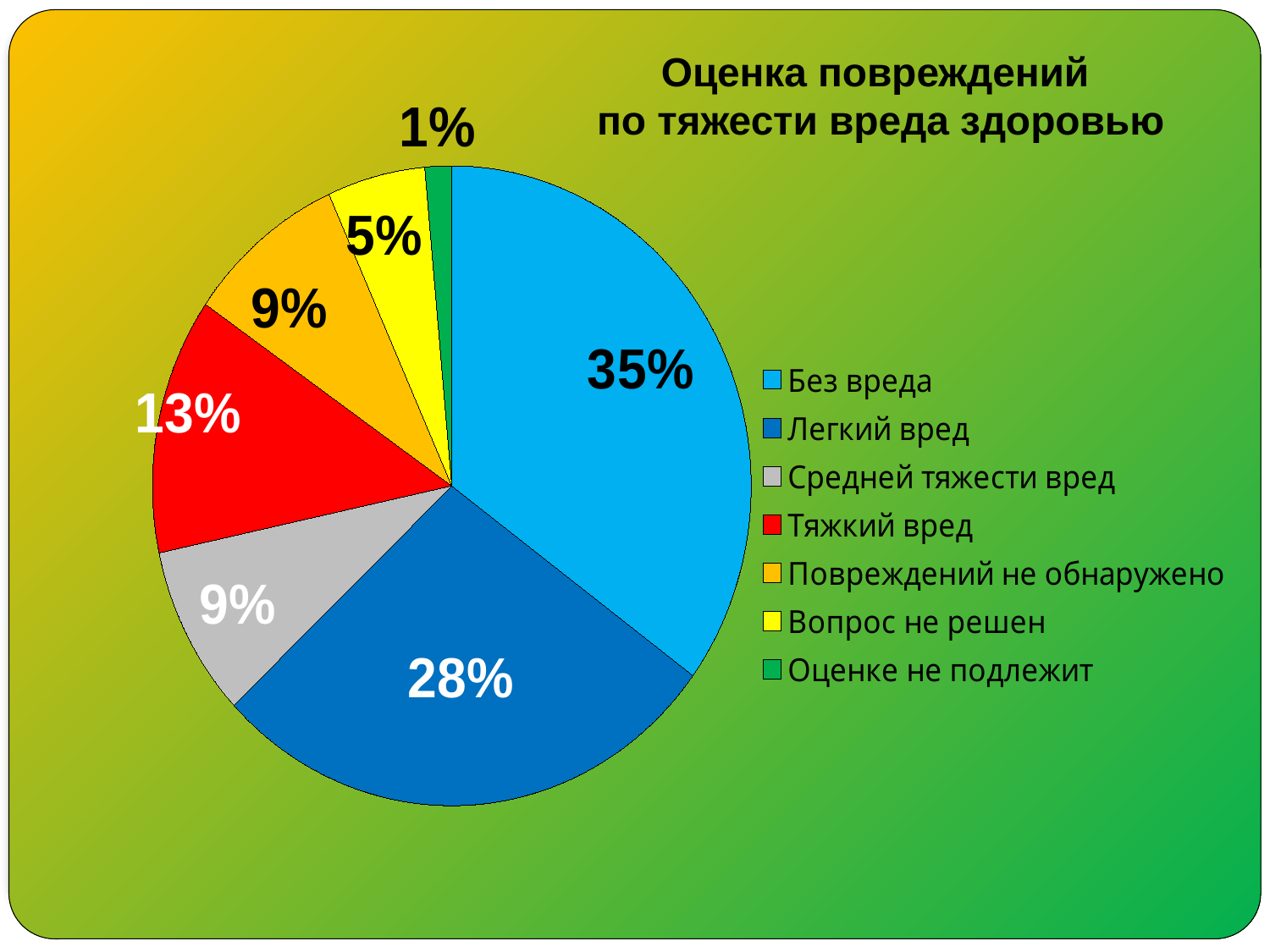
What share of the pie does "Легкий вред" take? 28% Which category has the smallest share of the pie? Оценке не подлежит What share of the pie does "Оценке не подлежит" take? 1% Which category has the largest share of the pie? Без вреда What is the difference between the shares of "Без вреда" and "Легкий вред"? 7% What share of the pie does "Без вреда" take? 35% What is the title of the chart? Оценка повреждений по тяжести вреда здоровью What type of chart is shown on the slide? pie chart How many categories does the legend list? 7 Which is larger, the share of "Тяжкий вред" or the share of "Вопрос не решен"? Тяжкий вред